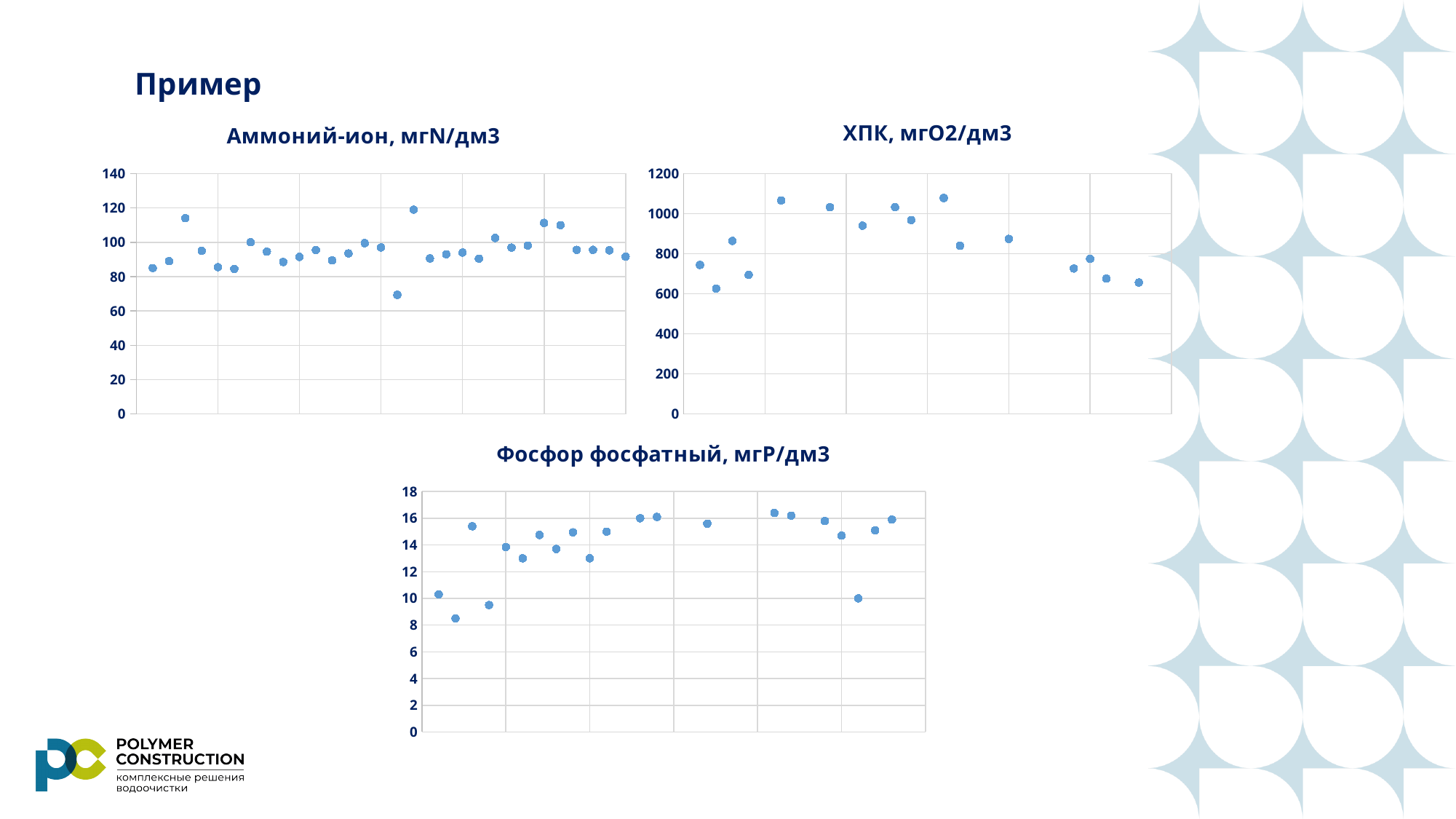
In the chart titled "Аммоний-ион, мгN/дм3", is the lowest point greater or less than 80? less What is the title of the chart at the bottom of the slide? Фосфор фосфатный, мгР/дм3 In the chart titled "ХПК, мгО2/дм3", is the last (rightmost) point greater or less than 800? less In the chart titled "Фосфор фосфатный, мгР/дм3", is the last (rightmost) point greater or less than 14? greater What is the maximum value shown on the vertical axis of the chart titled "ХПК, мгО2/дм3"? 1200 What type of chart is the chart titled "Аммоний-ион, мгN/дм3"? scatter chart In the chart titled "Фосфор фосфатный, мгР/дм3", do the values generally rise or fall from left to right? rise How many charts are shown on the slide? 3